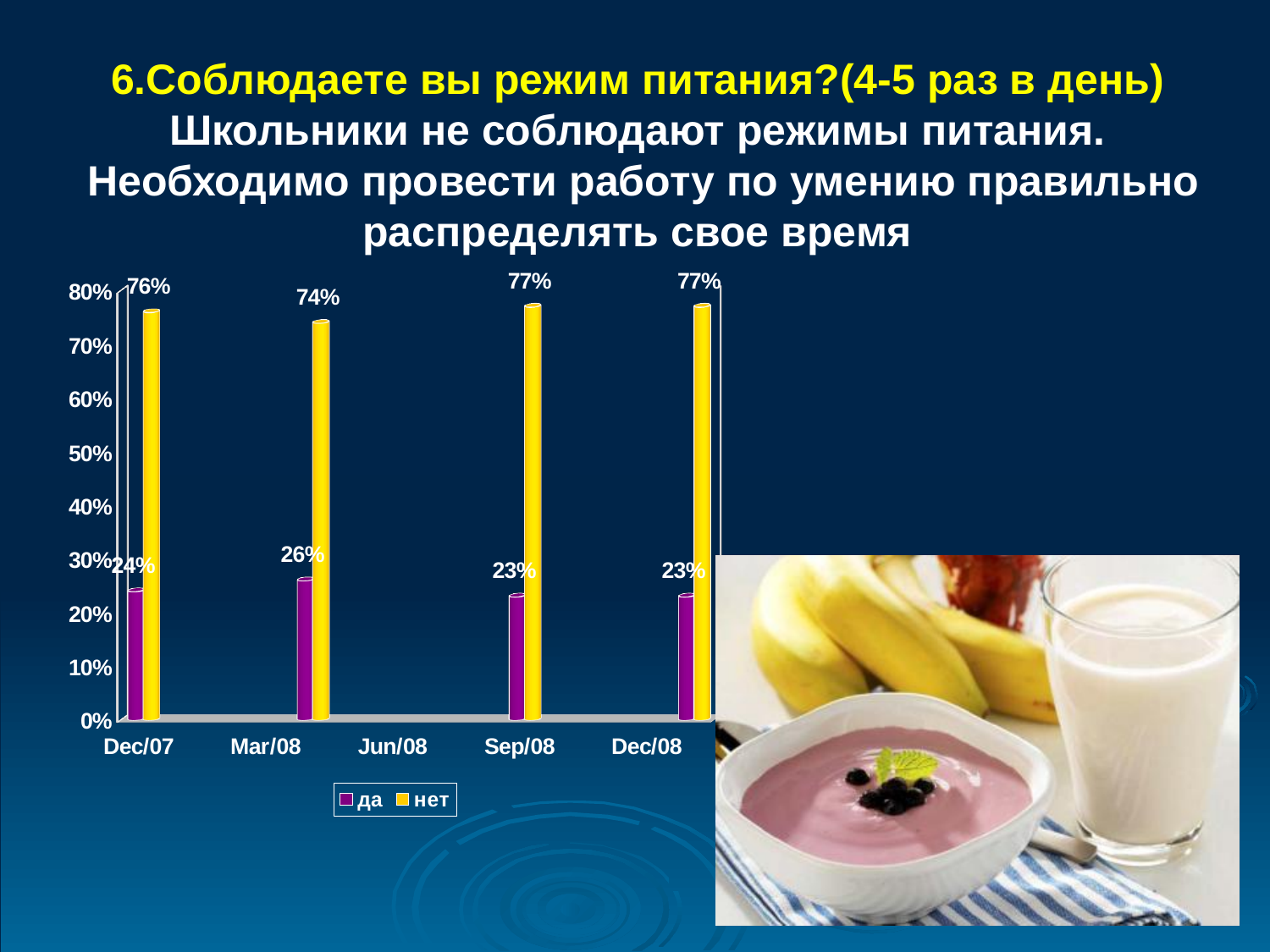
What is the value for "да" at Mar/08? 26% What is the value for "нет" at Dec/07? 76% At which date is the "да" value highest? Mar/08 What is the total of the "да" and "нет" values at Mar/08? 100% What is the difference between the "нет" and "да" values at Dec/07? 52% What kind of chart is shown on the slide? bar chart What is the value for "нет" at Sep/08? 77% At which date is the "нет" value lowest? Mar/08 What is the value for "да" at Dec/08? 23% How many series does the legend list? 2 Which is larger at Sep/08, the "да" value or the "нет" value? нет What colour are the bars for the "нет" series? yellow